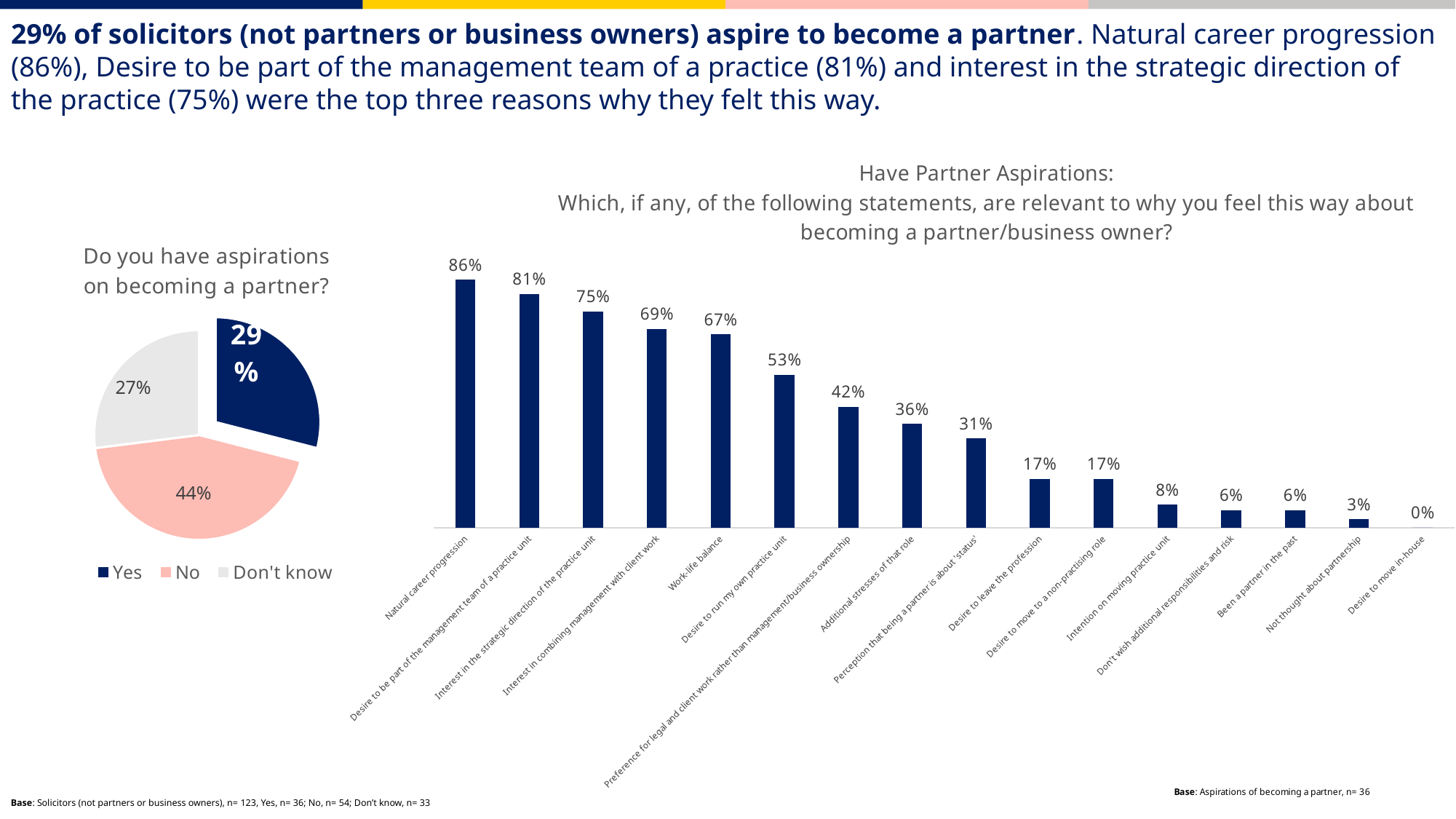
In the 'Have Partner Aspirations' chart, which statement has the highest value? Natural career progression In the 'Have Partner Aspirations' chart, which is larger: 'Additional stresses of that role' or 'Desire to leave the profession'? Additional stresses of that role In the pie chart 'Do you have aspirations on becoming a partner?', how many entries does the legend list? 3 In the pie chart 'Do you have aspirations on becoming a partner?', which response has the largest share? No In the 'Have Partner Aspirations' chart, what is the difference between 'Natural career progression' and 'Interest in the strategic direction of the practice unit'? 11% What kind of chart is the 'Have Partner Aspirations' chart? Bar chart In the pie chart 'Do you have aspirations on becoming a partner?', what share of respondents answered 'Don't know'? 27% In the pie chart 'Do you have aspirations on becoming a partner?', what share of respondents answered 'No'? 44% In the 'Have Partner Aspirations' chart, what is the value for 'Desire to run my own practice unit'? 53% In the 'Have Partner Aspirations' chart, which statement has the lowest value? Desire to move in-house In the 'Have Partner Aspirations' chart, how many statements are plotted? 16 In the 'Have Partner Aspirations' chart, what is the value for 'Work-life balance'? 67%